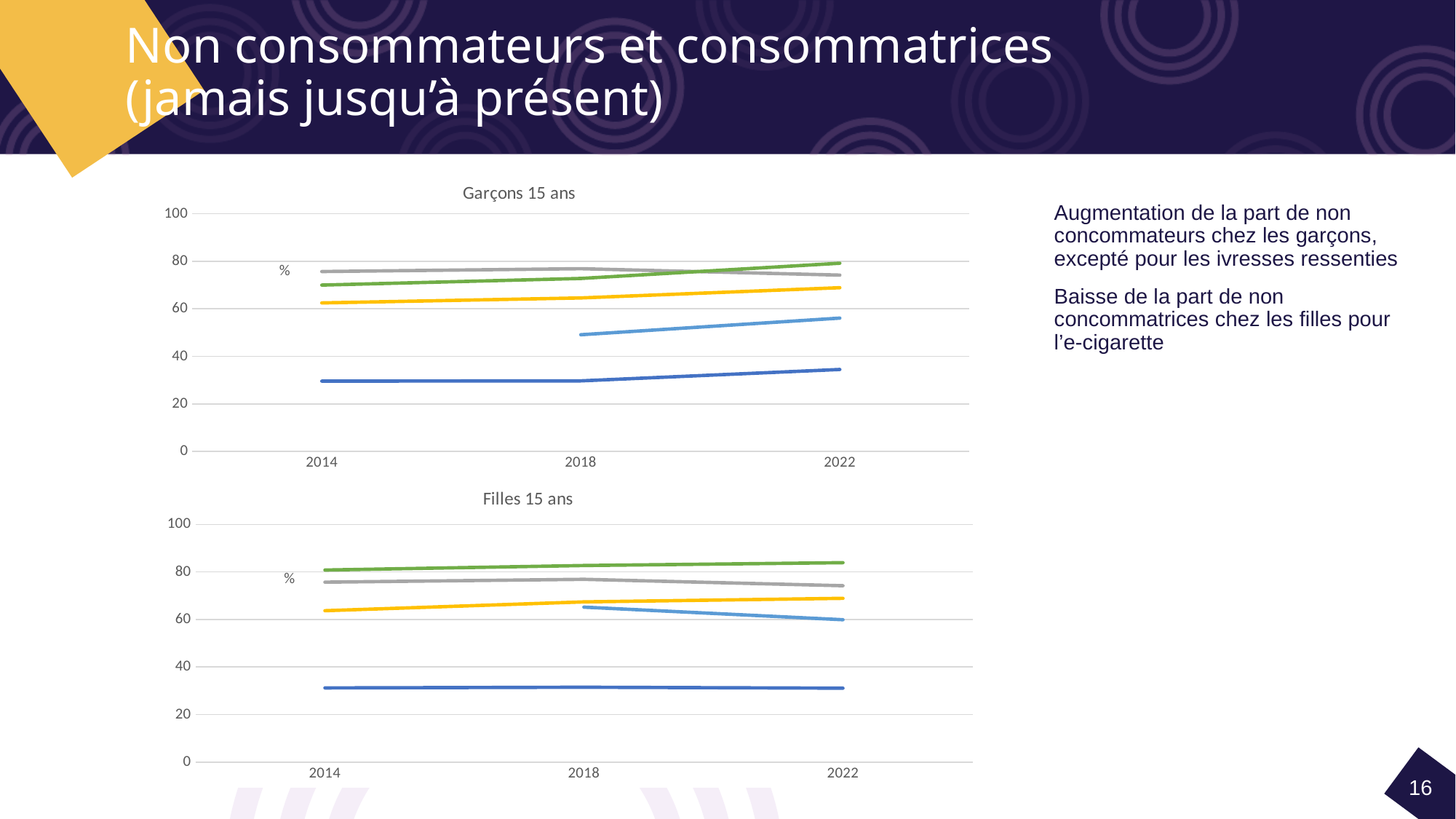
In the 'Garçons 15 ans' chart, is the value of the dark blue line in 2014 greater or less than 40? less In the 'Filles 15 ans' chart, does the light blue line rise or fall from 2018 to 2022? fall In the 'Filles 15 ans' chart, is the value of the dark blue line in 2022 greater or less than 40? less In the 'Garçons 15 ans' chart, which is higher in 2014: the green line or the dark blue line? the green line In the 'Garçons 15 ans' chart, in which year does the green line reach its highest value? 2022 What is the title of the top chart on the slide? Garçons 15 ans What type of chart is the 'Garçons 15 ans' chart? line chart In the 'Garçons 15 ans' chart, does the light blue line rise or fall from 2018 to 2022? rise How many years are shown on the x axis of the 'Garçons 15 ans' chart? 3 In the 'Garçons 15 ans' chart, is the value of the green line in 2022 greater or less than 60? greater What is the title of the bottom chart on the slide? Filles 15 ans How many lines are plotted in the 'Filles 15 ans' chart? 5